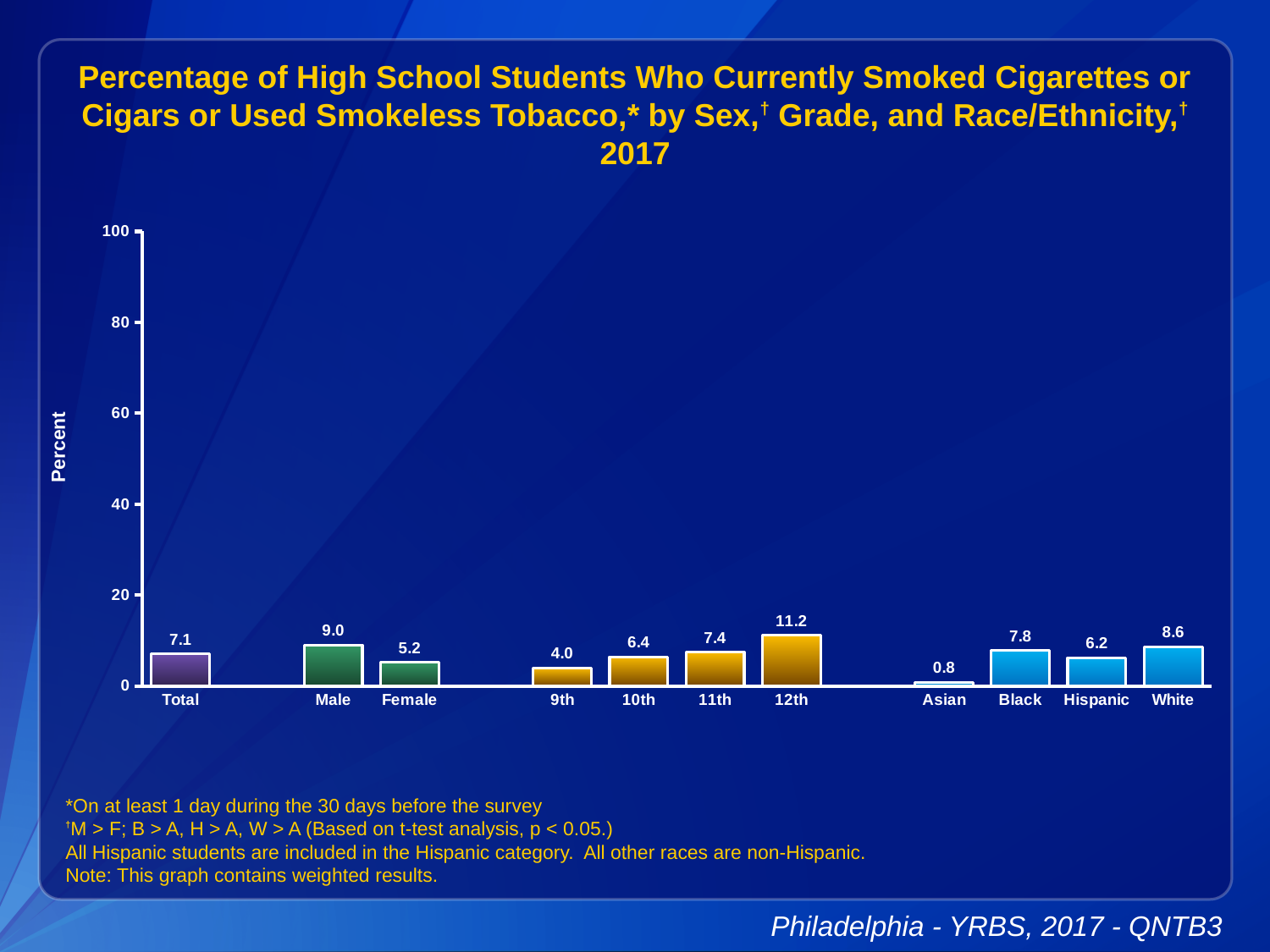
What is the difference between the Male and Female values? 3.8 Do the values rise or fall from 9th grade to 12th grade? rise What is the value for Male? 9.0 How many categories are shown on the x axis? 11 What is the value for Asian students? 0.8 Which category has the lowest value? Asian What is the value for Total? 7.1 What kind of chart is this? bar chart Which category has the highest value? 12th Which is larger, the value for Black or the value for Hispanic? Black What is the value for 12th grade? 11.2 Is the value for White greater or less than 20? less